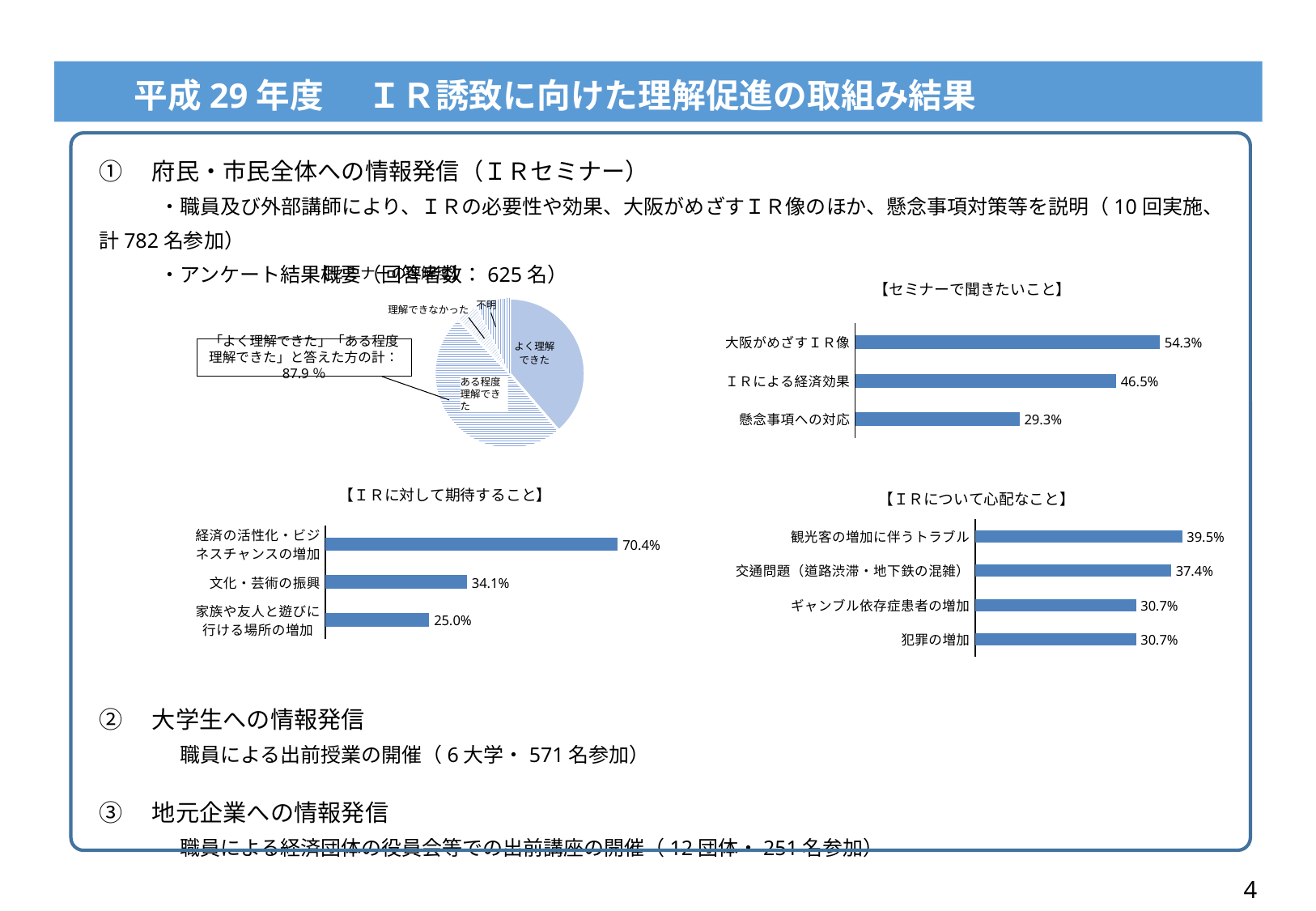
In the 【ＩＲに対して期待すること】 chart, which is larger: 経済の活性化・ビジネスチャンスの増加 or 文化・芸術の振興? 経済の活性化・ビジネスチャンスの増加 In the 【ＩＲに対して期待すること】 chart, which category has the lowest value? 家族や友人と遊びに行ける場所の増加 How many categories are shown in the 【ＩＲについて心配なこと】 chart? 4 In the 【ＩＲについて心配なこと】 chart, which category has the highest value? 観光客の増加に伴うトラブル In the 【ＩＲに対して期待すること】 chart, what is the value for 文化・芸術の振興? 34.1% How many categories are shown in the 【ＩＲに対して期待すること】 chart? 3 In the pie chart at the top left, what combined share of respondents answered 「よく理解できた」 or 「ある程度理解できた」? 87.9% What kind of chart is the 【ＩＲについて心配なこと】 chart? Bar chart In the 【セミナーで聞きたいこと】 chart, which category has the highest value? 大阪がめざすＩＲ像 In the 【セミナーで聞きたいこと】 chart, what is the value for 大阪がめざすＩＲ像? 54.3% In the 【セミナーで聞きたいこと】 chart, what is the difference between 大阪がめざすＩＲ像 and 懸念事項への対応? 25.0 percentage points In the 【ＩＲについて心配なこと】 chart, what is the value for 交通問題（道路渋滞・地下鉄の混雑）? 37.4%